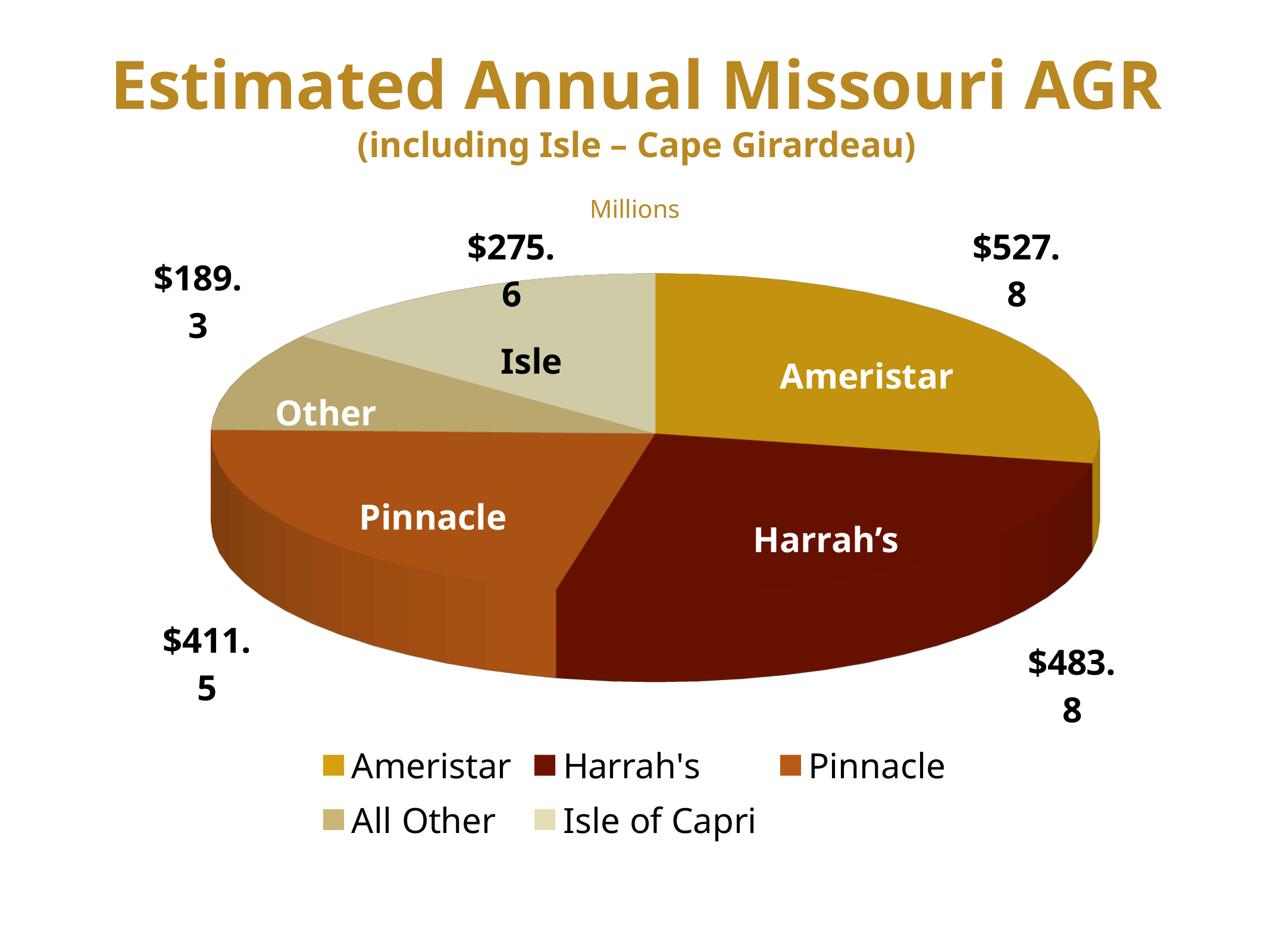
What is the value shown for the Isle of Capri slice? $275.6 What kind of chart is shown on the slide? Pie chart How much larger is Ameristar's value than Harrah's? $44.0 What is the value shown for the All Other slice? $189.3 Which is larger, the Isle of Capri value or the All Other value? Isle of Capri What is the value shown for Pinnacle? $411.5 What is the difference between the Pinnacle and All Other values? $222.2 Which operator has the largest slice of the pie? Ameristar How many slices does the pie chart have? 5 What is the estimated annual Missouri AGR for Ameristar? $527.8 What is the value shown for Harrah's? $483.8 Which slice of the pie is the smallest? All Other